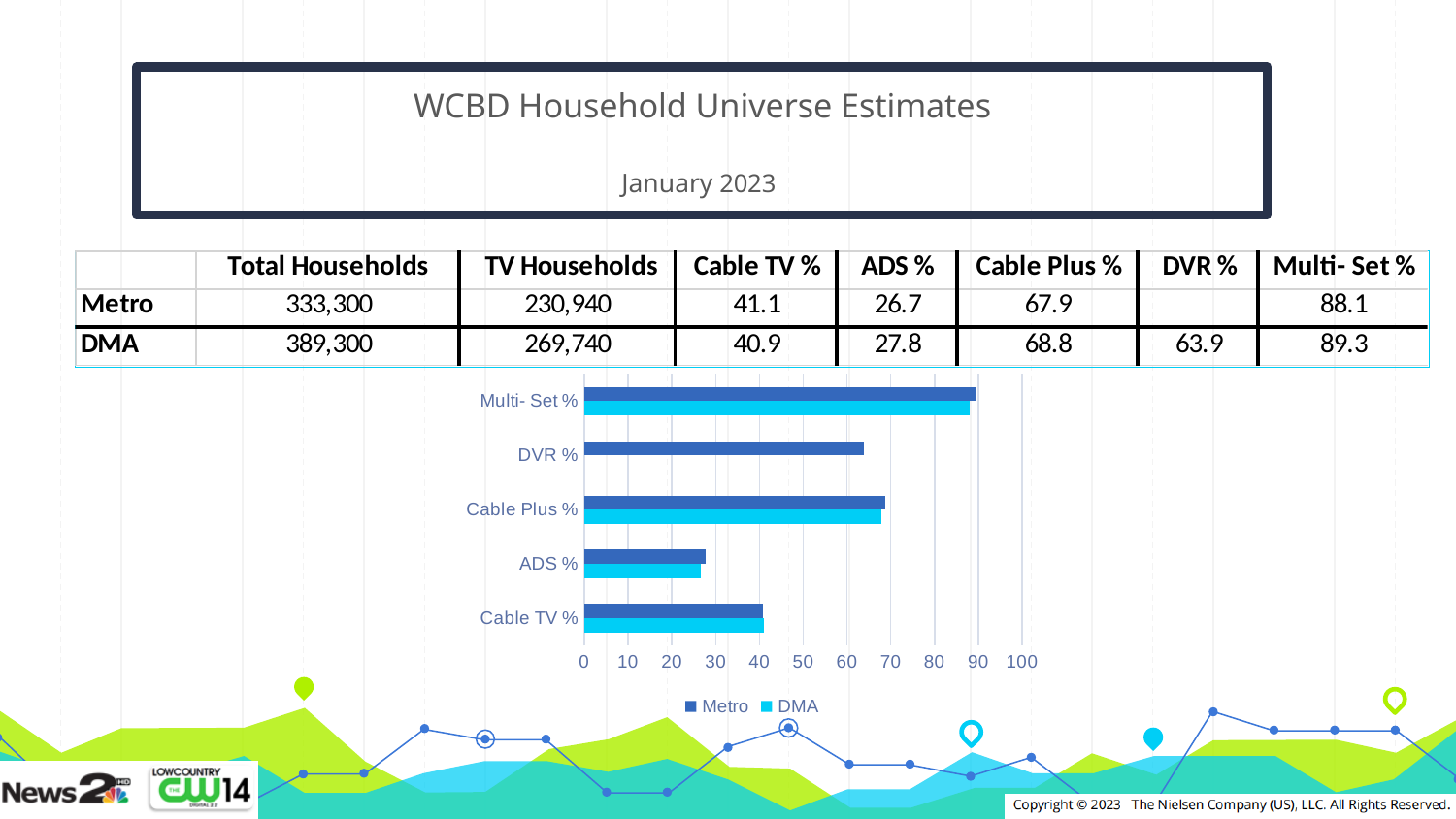
How many categories are plotted on the bar chart? 5 Which category has the longest bars in the chart? Multi- Set % Which category has the shortest bars in the chart? ADS % How many series does the chart legend list? 2 What are the two series named in the chart legend? Metro and DMA Is the value for ADS % greater or less than 30 in the chart? less Which category in the chart has only one bar plotted? DVR % What kind of chart is shown on the slide? bar chart According to the table, what is the Cable Plus % for DMA? 68.8 Is the value for Multi- Set % greater or less than 80 in the chart? greater According to the table, what is the Multi- Set % for Metro? 88.1 Is the value for Cable Plus % greater or less than 60 in the chart? greater